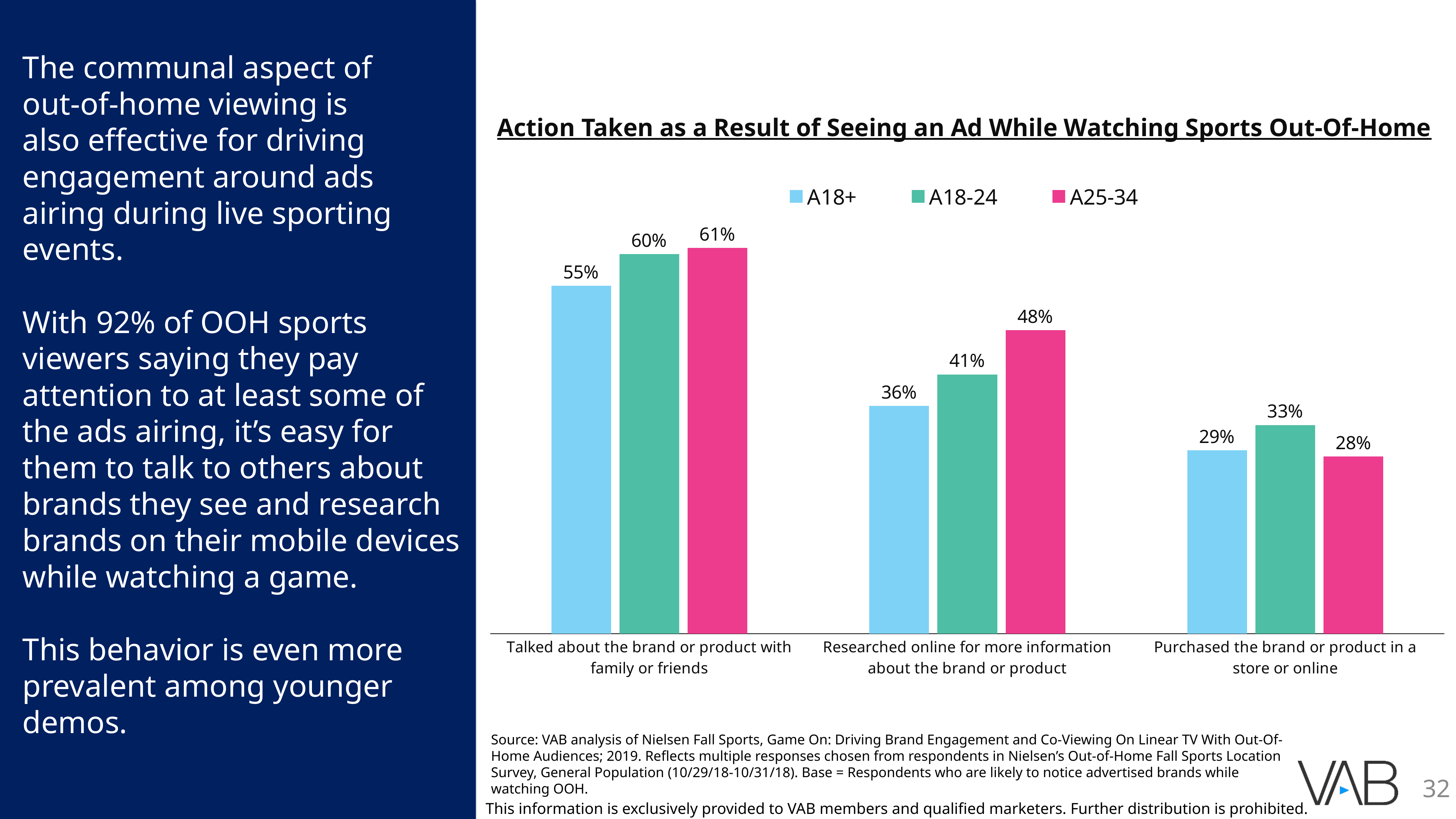
Which category has the lowest value for A18+? Purchased the brand or product in a store or online How many categories are shown on the x axis? 3 What is the value for A18-24 for 'Purchased the brand or product in a store or online'? 33% What is the difference between the A25-34 and A18+ values for 'Researched online for more information about the brand or product'? 12% Which category has the highest value for A25-34? Talked about the brand or product with family or friends What is the value for A25-34 for 'Researched online for more information about the brand or product'? 48% What is the value for A18+ for 'Talked about the brand or product with family or friends'? 55% What is the title of the chart? Action Taken as a Result of Seeing an Ad While Watching Sports Out-Of-Home How many series does the legend list? 3 What kind of chart is shown on the slide? Bar chart Do the A18+ values rise or fall across the categories from left to right? Fall For 'Purchased the brand or product in a store or online', which is larger: A18-24 or A25-34? A18-24